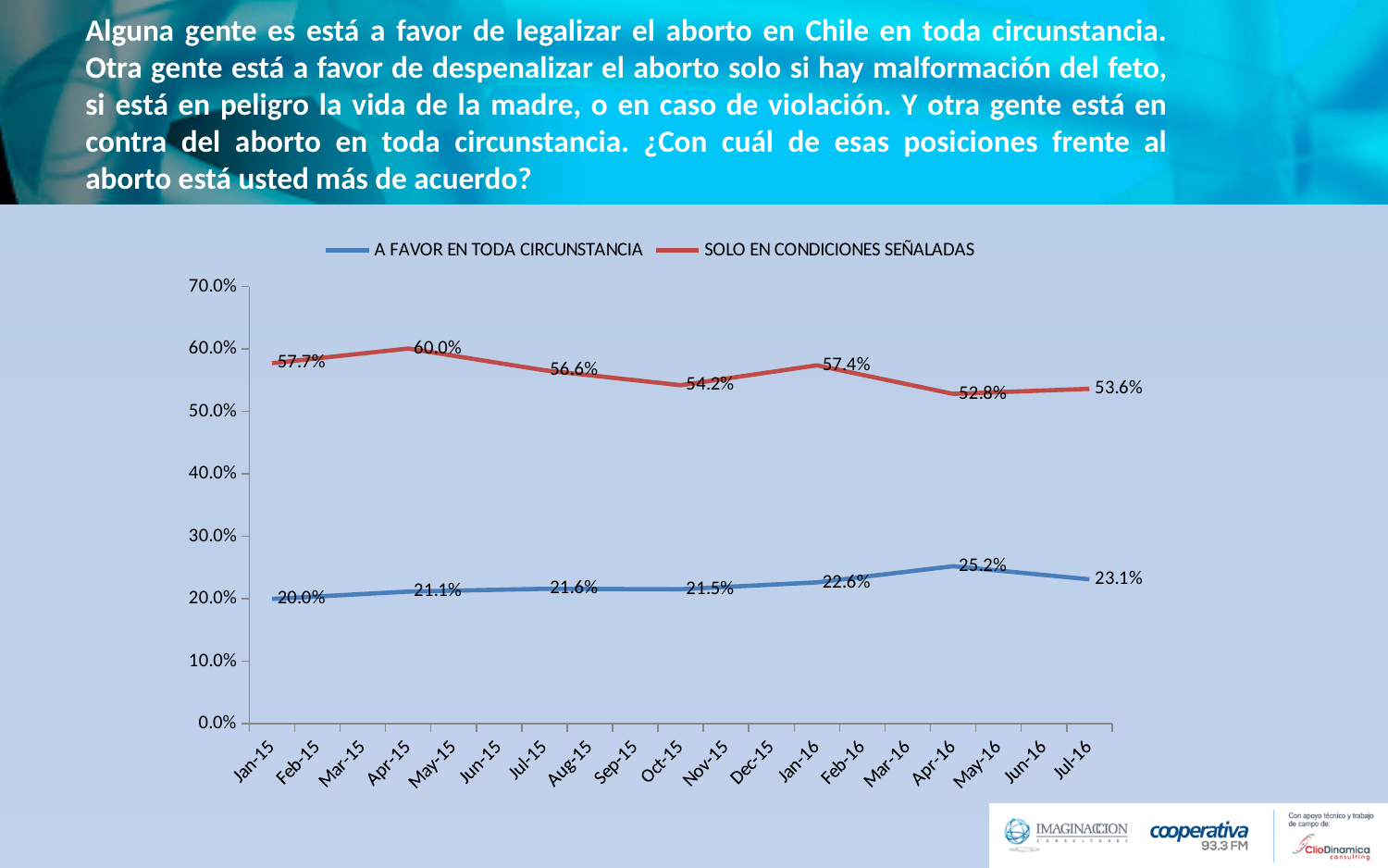
What is the difference between the two series in Jan-16? 34.8% How many data points are plotted for each series? 7 What colour is the line for A FAVOR EN TODA CIRCUNSTANCIA? Blue In which month does SOLO EN CONDICIONES SEÑALADAS reach its lowest value? Apr-16 What is the value for A FAVOR EN TODA CIRCUNSTANCIA in Jan-15? 20.0% How many series does the legend list? 2 What is the value for A FAVOR EN TODA CIRCUNSTANCIA in Jul-16? 23.1% Which series has the higher value in Oct-15? SOLO EN CONDICIONES SEÑALADAS What is the value for SOLO EN CONDICIONES SEÑALADAS in Apr-15? 60.0% In which month does SOLO EN CONDICIONES SEÑALADAS reach its highest value? Apr-15 In which month does A FAVOR EN TODA CIRCUNSTANCIA reach its highest value? Apr-16 What kind of chart is shown on the slide? Line chart